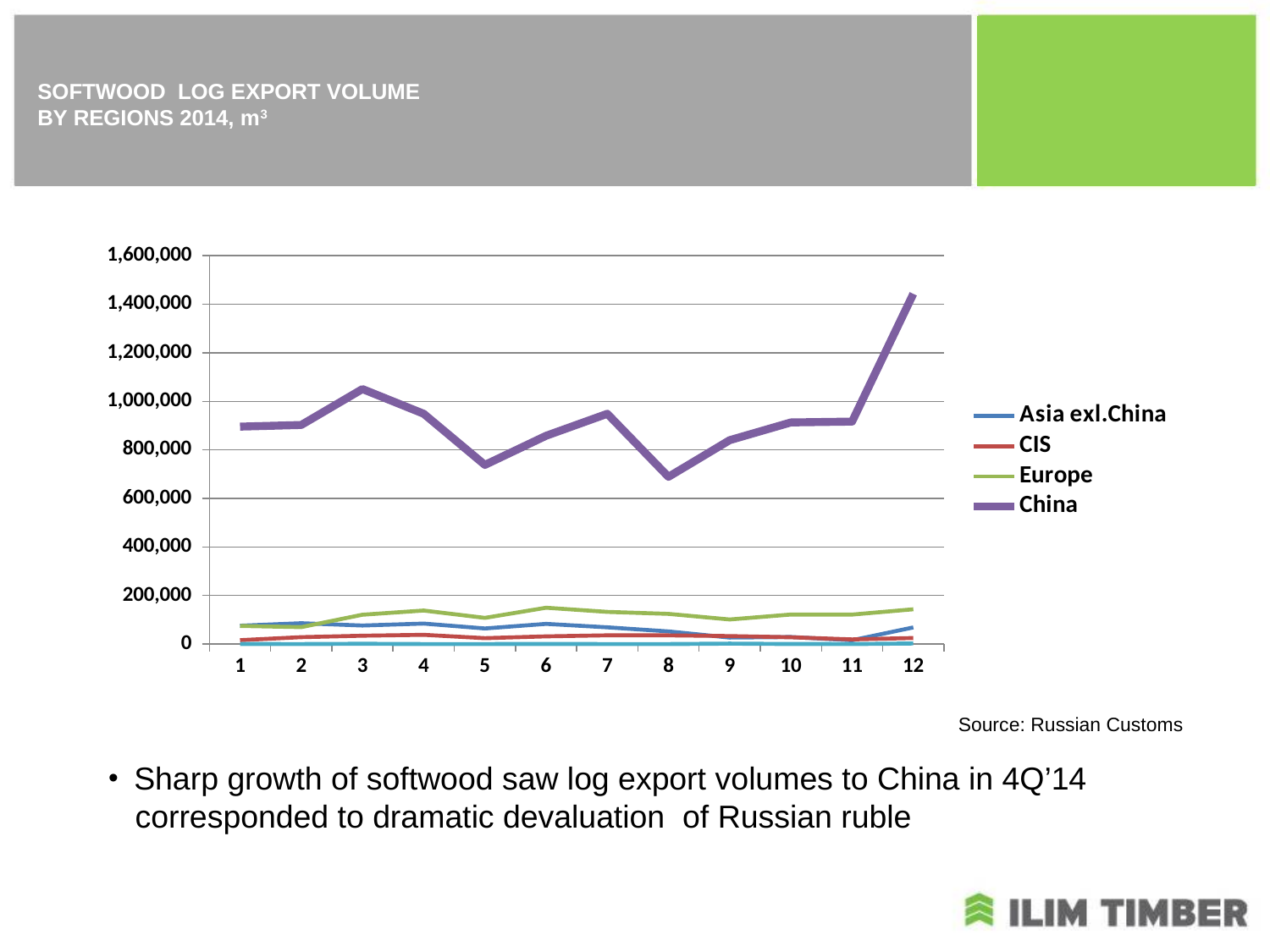
At which x-axis point does the China series reach its highest value? 12 Is the value for China at point 12 greater or less than 1,200,000? greater How many series does the legend list? 4 How many points are plotted along the x axis for each series? 12 Is the value for China at point 8 greater or less than 800,000? less What kind of chart is shown on the slide? line chart At which x-axis point does the China series reach its lowest value? 8 Does the China series rise or fall from point 11 to point 12? rise Which series has the larger value at point 1, China or Europe? China Which series has the larger value at point 6, Europe or Asia exl.China? Europe What colour is the China line in the legend? purple Is the value for Europe at point 6 greater or less than 400,000? less